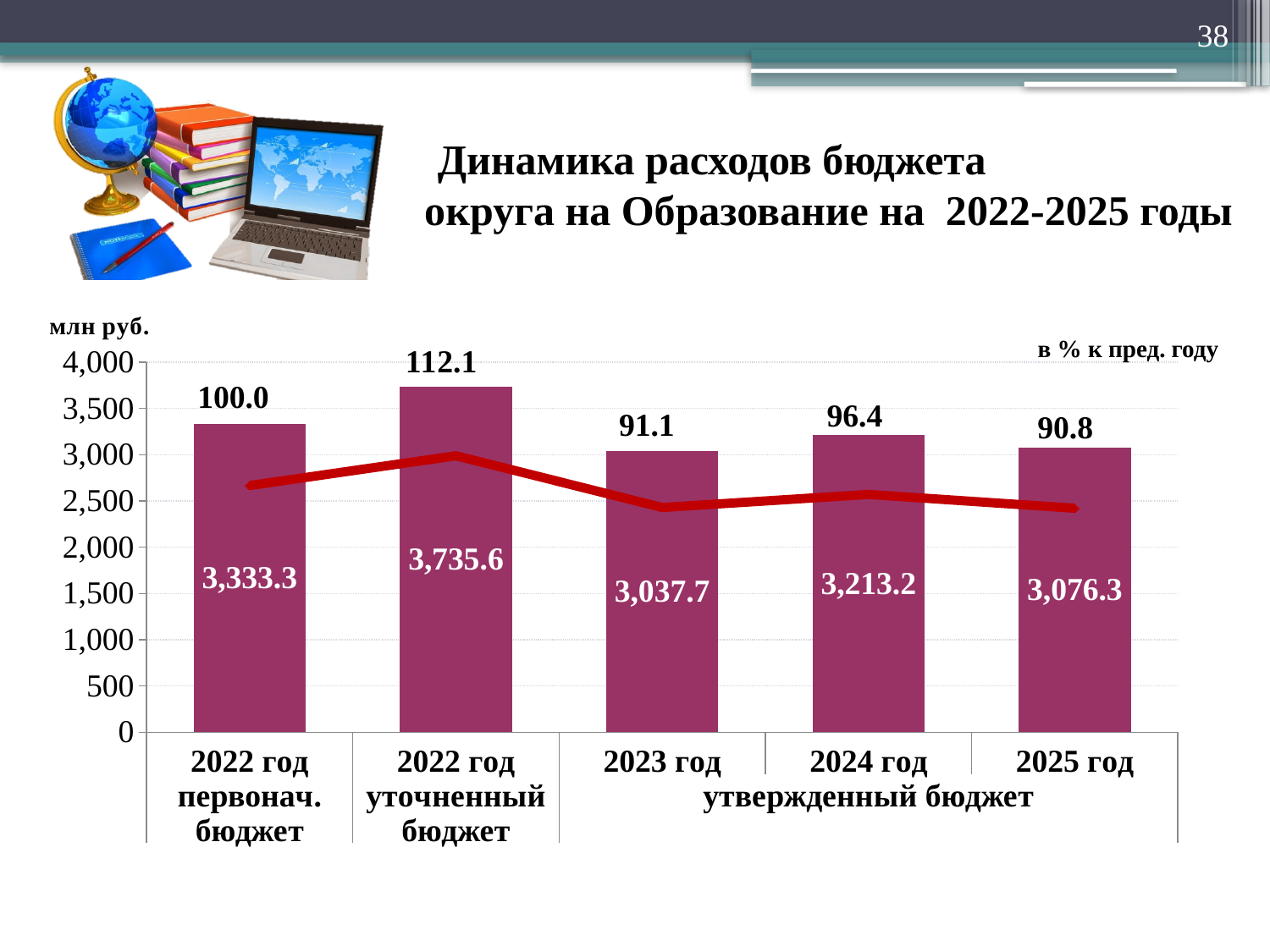
Which is larger, the bar value for 2024 год or for 2025 год? 2024 год How many categories are shown on the x axis? 5 What is the budget expenditure on education (млн руб.) for 2024 год? 3,213.2 Which category has the highest bar value (млн руб.)? 2022 год уточненный бюджет Which category has the lowest bar value (млн руб.)? 2023 год What is the unit label shown above the vertical axis? млн руб. What kind of chart is shown on the slide? Combined bar and line chart Is the bar value for 2023 год greater or less than 3,500? less What is the budget expenditure on education (млн руб.) for 2022 год уточненный бюджет? 3,735.6 What is the value in % к пред. году shown for 2023 год? 91.1 What is the value in % к пред. году shown for 2025 год? 90.8 What is the difference in млн руб. between 2022 год уточненный бюджет and 2022 год первонач. бюджет? 402.3